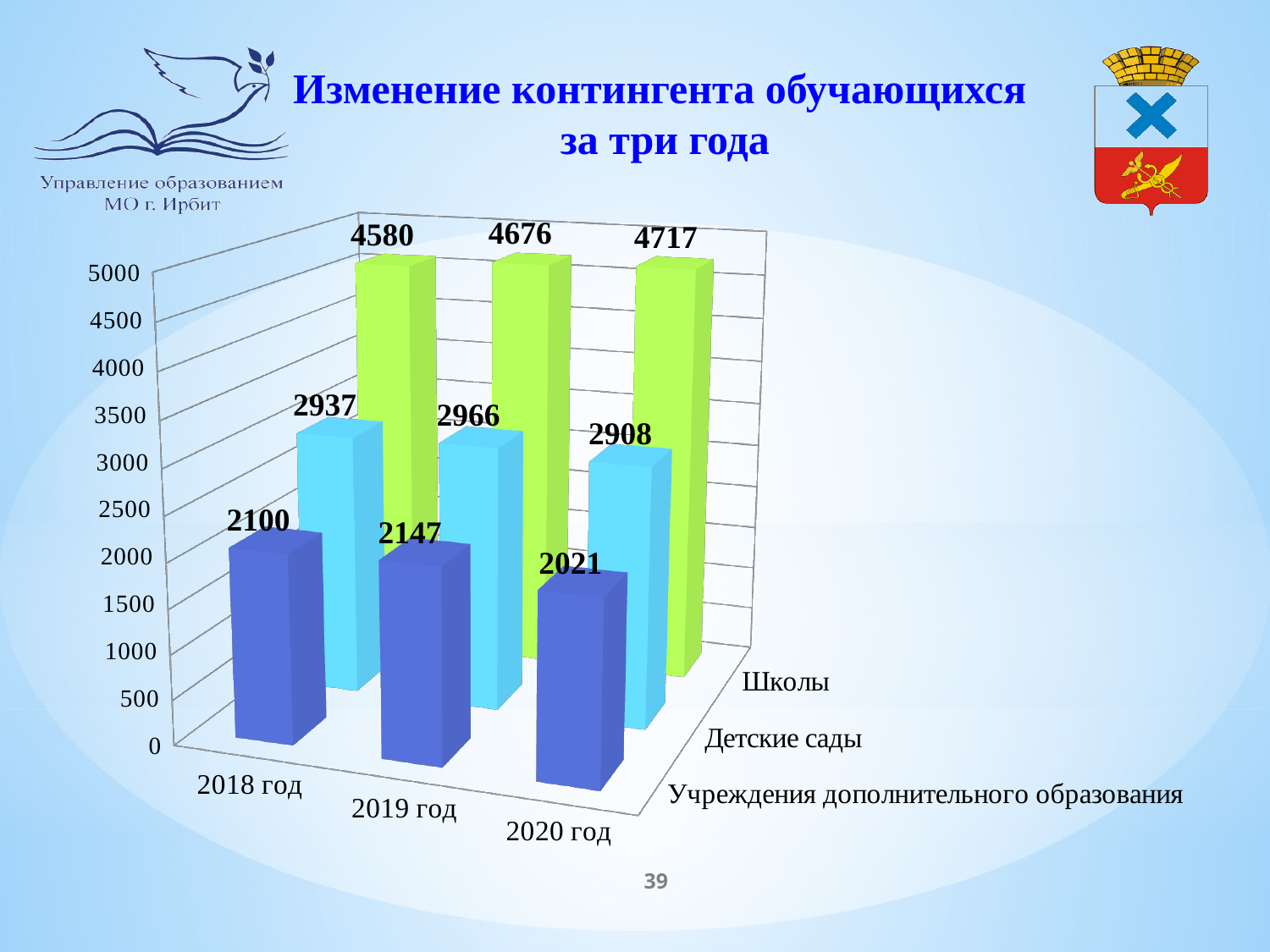
How many years are shown on the x axis? 3 Which is larger: Детские сады in 2019 год or Детские сады in 2020 год? Детские сады in 2019 год What is the value for Школы in 2020 год? 4717 What is the value for Детские сады in 2018 год? 2937 What type of chart is shown on the slide? bar chart In which year was the value for Школы the highest? 2020 год How many series does the chart show? 3 Do the values for Школы rise or fall from 2018 год to 2020 год? rise What is the difference between the Школы values for 2020 год and 2018 год? 137 Is the value for Школы in 2018 год greater or less than 4500? greater In which year was the value for Учреждения дополнительного образования the lowest? 2020 год What is the value for Учреждения дополнительного образования in 2019 год? 2147